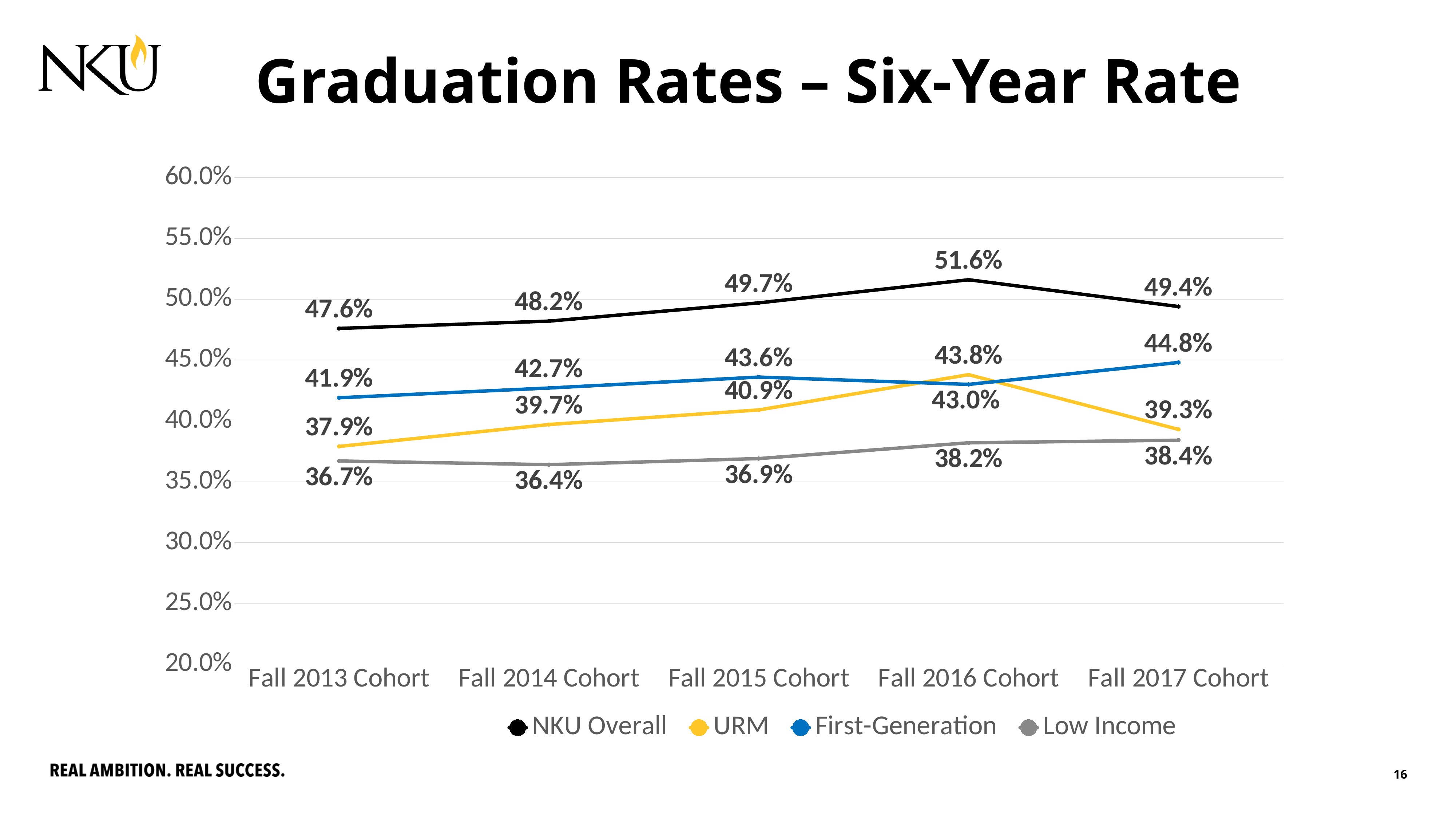
How many series does the legend list? 4 For the Fall 2016 Cohort, which is larger: the URM rate or the First-Generation rate? URM What is the First-Generation rate for the Fall 2017 Cohort? 44.8% What is the Low Income rate for the Fall 2013 Cohort? 36.7% Does the URM rate rise or fall from the Fall 2016 Cohort to the Fall 2017 Cohort? fall What is the difference between the NKU Overall rate and the Low Income rate for the Fall 2017 Cohort? 11.0% What is the NKU Overall six-year graduation rate for the Fall 2016 Cohort? 51.6% For which cohort is the NKU Overall rate highest? Fall 2016 Cohort What is the URM rate for the Fall 2014 Cohort? 39.7% What type of chart is shown on the slide? line chart For which cohort is the Low Income rate lowest? Fall 2014 Cohort How many cohorts are plotted along the x axis? 5